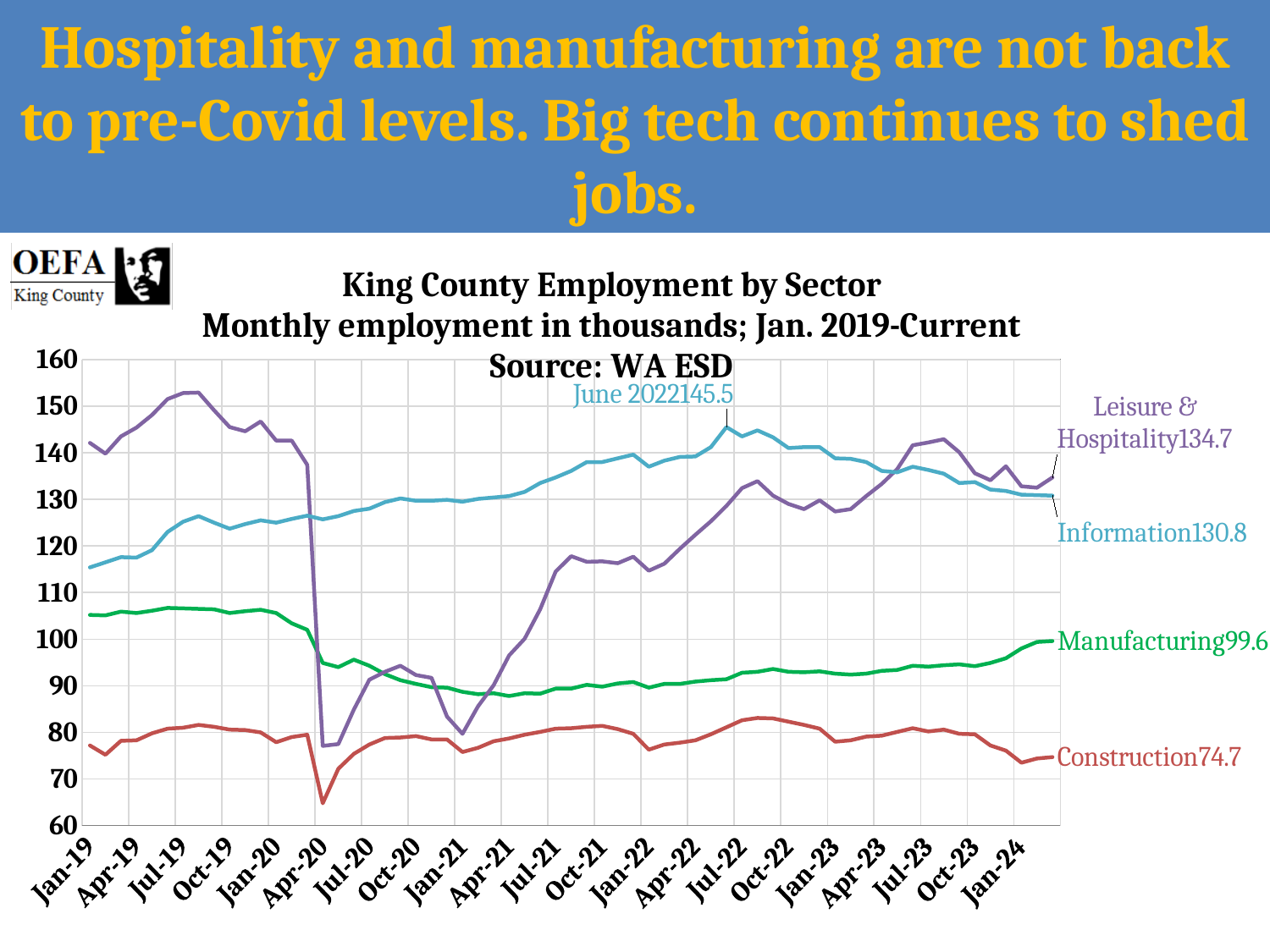
What kind of chart is shown? Line chart How many series are plotted on the chart? 4 Which sector has the lowest latest value? Construction What is the latest value shown for Leisure & Hospitality? 134.7 What is the latest value shown for Manufacturing? 99.6 How much did Information fall from its June 2022 value to its latest value? 14.7 What is the difference between the latest Leisure & Hospitality value and the latest Information value? 3.9 Is the value for Construction in Apr-20 greater or less than 70? less What is the latest value shown for Information? 130.8 What value is labelled for Information in June 2022? 145.5 Does the Information line rise or fall from June 2022 to the end of the chart? Fall Which is larger at the latest point, Manufacturing or Construction? Manufacturing